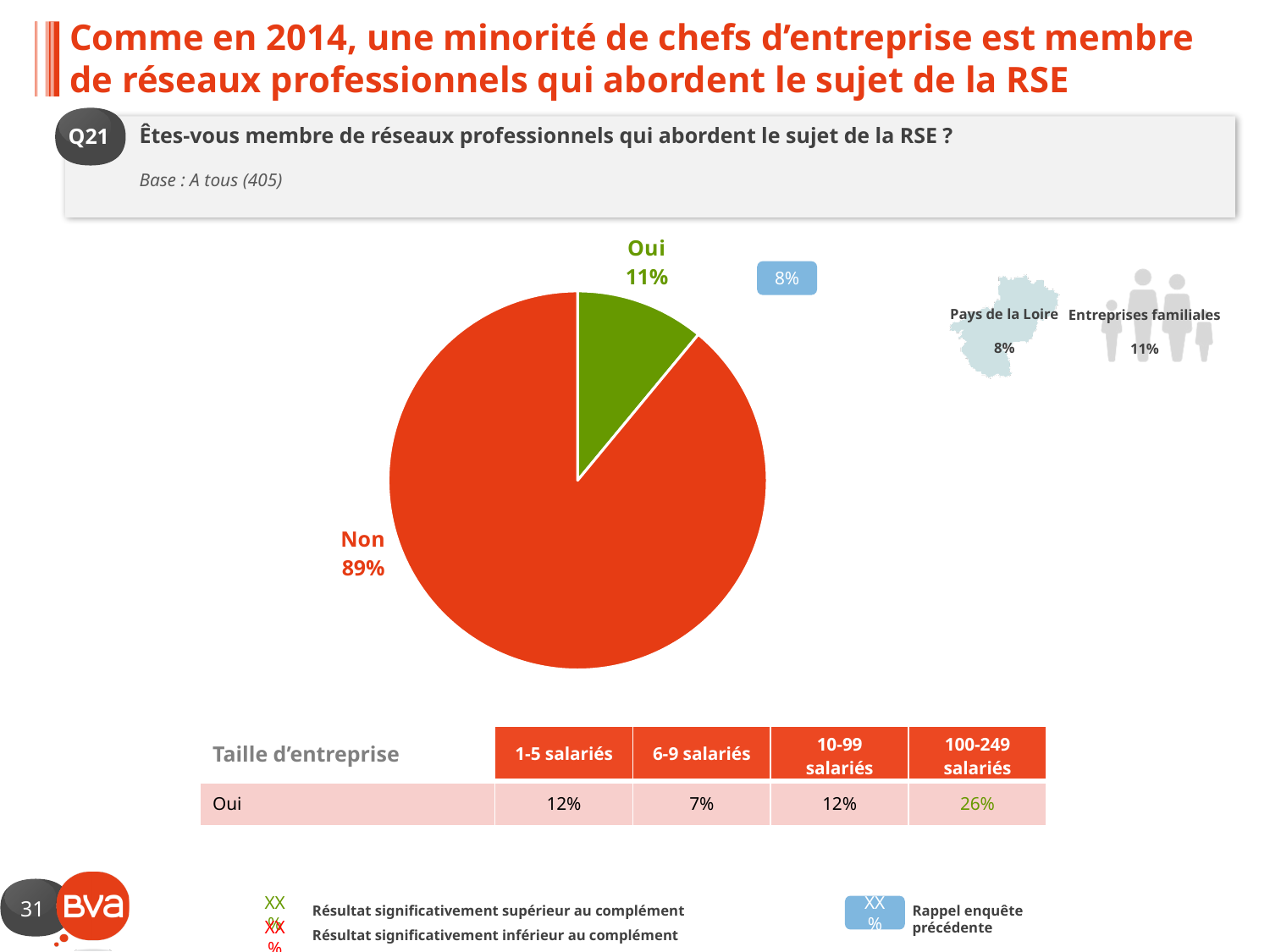
What colour is the "Non" slice of the pie chart? red-orange Which is larger in the pie chart, "Oui" or "Non"? Non What colour is the "Oui" slice of the pie chart? green What value is shown in the blue box next to the "Oui" slice, recalling the previous survey? 8% What is the difference in percentage points between the "Non" and "Oui" slices? 78 Which slice of the pie chart is the largest? Non What kind of chart is shown on the slide? pie chart How many slices does the pie chart have? 2 What share of the pie does the "Oui" slice represent? 11% What share of the pie does the "Non" slice represent? 89% Which slice of the pie chart is the smallest? Oui